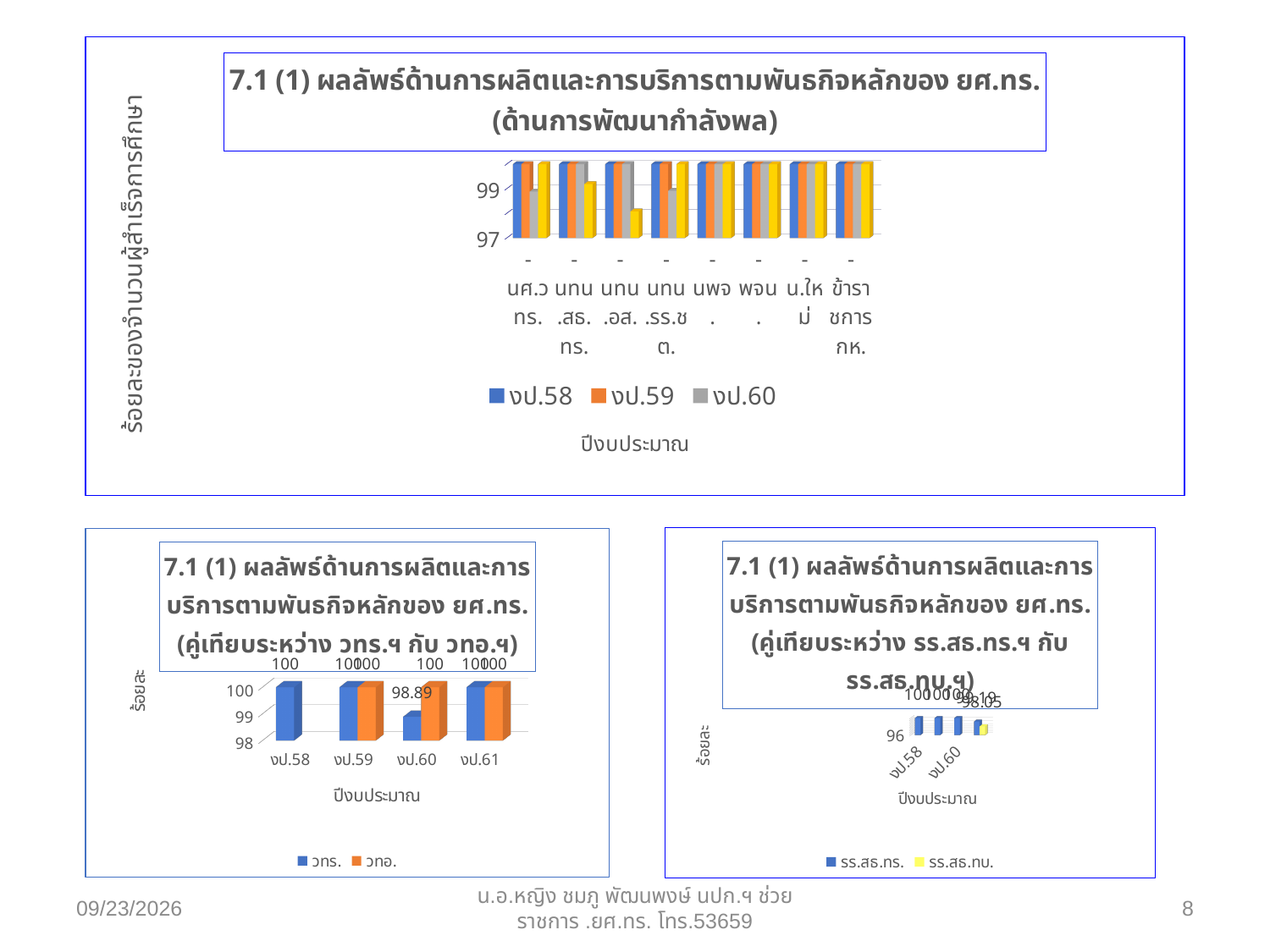
In the bottom-left chart (คู่เทียบระหว่าง วทร.ฯ กับ วทอ.ฯ), which year has the lowest วทร. value? งป.60 In the bottom-left chart (คู่เทียบระหว่าง วทร.ฯ กับ วทอ.ฯ), how many years are shown on the x axis? 4 In the bottom-left chart (คู่เทียบระหว่าง วทร.ฯ กับ วทอ.ฯ), how many series does the legend list? 2 In the bottom-left chart (คู่เทียบระหว่าง วทร.ฯ กับ วทอ.ฯ), for งป.60, which is larger: วทร. or วทอ.? วทอ. In the top chart (ด้านการพัฒนากำลังพล), how many series does the legend list? 3 In the bottom-right chart (คู่เทียบระหว่าง รร.สธ.ทร.ฯ กับ รร.สธ.ทบ.ฯ), what are the two series listed in the legend? รร.สธ.ทร. and รร.สธ.ทบ. In the bottom-left chart (คู่เทียบระหว่าง วทร.ฯ กับ วทอ.ฯ), what is the difference between the วทอ. and วทร. values for งป.60? 1.11 In the bottom-left chart (คู่เทียบระหว่าง วทร.ฯ กับ วทอ.ฯ), what is the วทร. value for งป.60? 98.89 In the top chart (ด้านการพัฒนากำลังพล), is the งป.58 value for นศ.วทร. greater or less than 99? greater What kind of chart is the top chart titled '7.1 (1) ผลลัพธ์ด้านการผลิตและการบริการตามพันธกิจหลักของ ยศ.ทร. (ด้านการพัฒนากำลังพล)'? bar chart In the top chart (ด้านการพัฒนากำลังพล), how many categories are shown on the x axis? 8 In the bottom-left chart (คู่เทียบระหว่าง วทร.ฯ กับ วทอ.ฯ), what is the วทอ. value for งป.60? 100